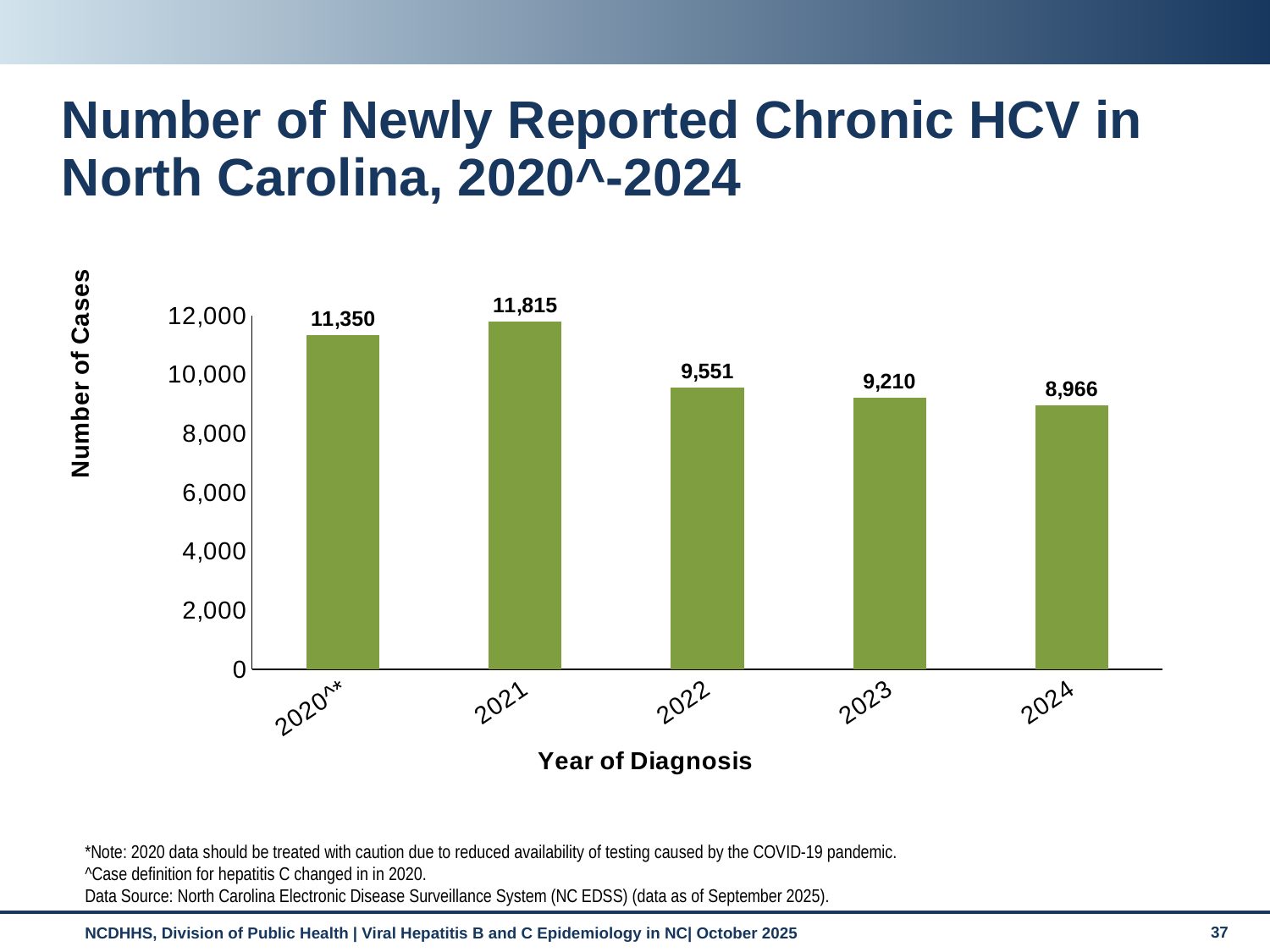
What is the difference in cases between 2021 and 2022? 2,264 What kind of chart is shown on the slide? Bar chart What is the number of cases shown for 2022? 9,551 Which year had more cases, 2020 or 2023? 2020 Is the value for 2023 greater or less than 10,000? less Which year has the lowest number of newly reported chronic HCV cases? 2024 From 2021 to 2024, do the number of cases rise or fall? Fall Which year has the highest number of newly reported chronic HCV cases? 2021 What is the difference in cases between 2023 and 2024? 244 How many years are shown on the x axis? 5 What is the number of newly reported chronic HCV cases in 2021? 11,815 What is the number of newly reported chronic HCV cases in 2024? 8,966